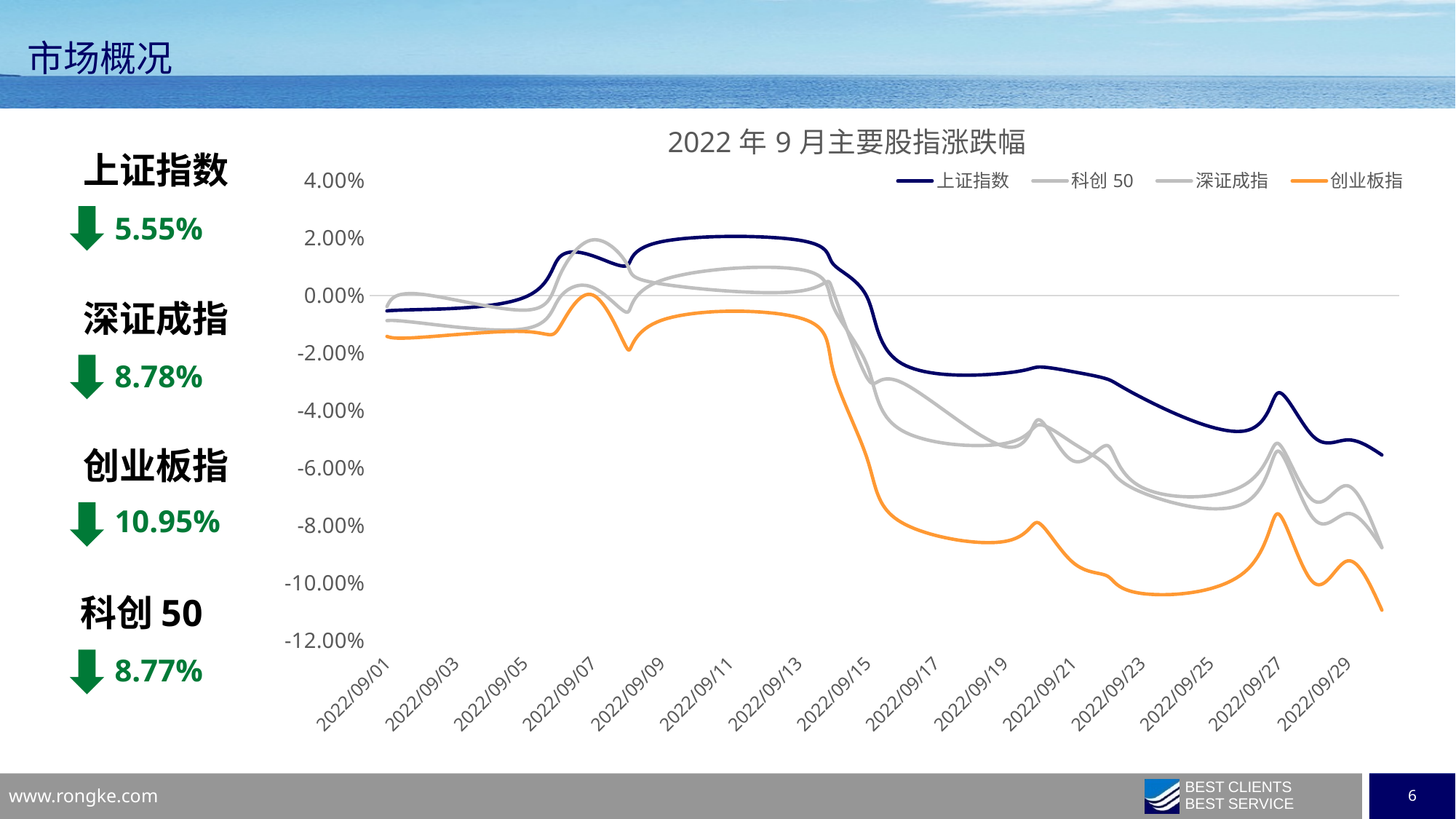
Is the value for 创业板指 at the end of the month (2022/09/30) greater or less than -10.00%? less How many date labels are shown on the x axis of the chart? 15 Which series in the chart is drawn in orange? 创业板指 How many series does the legend of the chart list? 4 Is the value for 创业板指 on 2022/09/11 greater or less than 0.00%? less Is the value for 上证指数 on 2022/09/11 greater or less than 0.00%? greater Which series has the highest value at the end of the month in the chart? 上证指数 What kind of chart is shown on the slide? line chart Which series has the lowest value at the end of the month in the chart? 创业板指 What is the title of the chart? 2022 年 9 月主要股指涨跌幅 Do the values of 上证指数 generally rise or fall from 2022/09/13 to 2022/09/29? fall